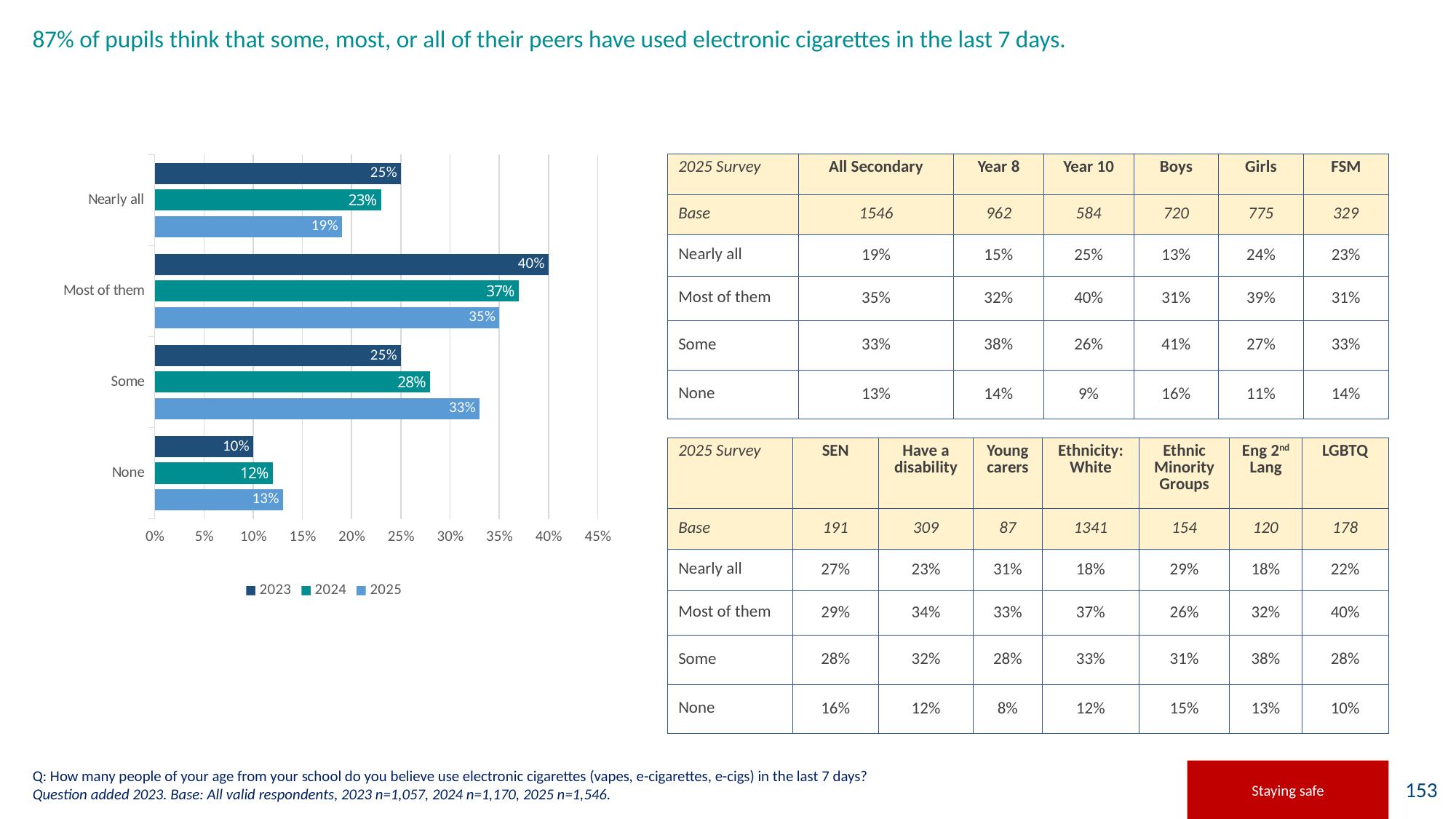
What is the 2025 value for 'Most of them' in the bar chart? 35% In the bar chart, is the 2024 value for 'Some' larger or the 2025 value for 'Some'? 2025 Which category has the lowest 2023 value in the bar chart? None What kind of chart is shown on the slide? Bar chart What is the 2024 value for 'None' in the bar chart? 12% How many categories are shown on the bar chart? 4 In the bar chart, do the values for 'Some' rise or fall from 2023 to 2025? Rise How many series does the legend of the bar chart list? 3 What is the difference between the 2023 and 2025 values for 'Nearly all' in the bar chart? 6% Which category has the highest 2025 value in the bar chart? Most of them What is the 2023 value for 'Some' in the bar chart? 25% What years are listed in the legend of the bar chart? 2023, 2024, 2025